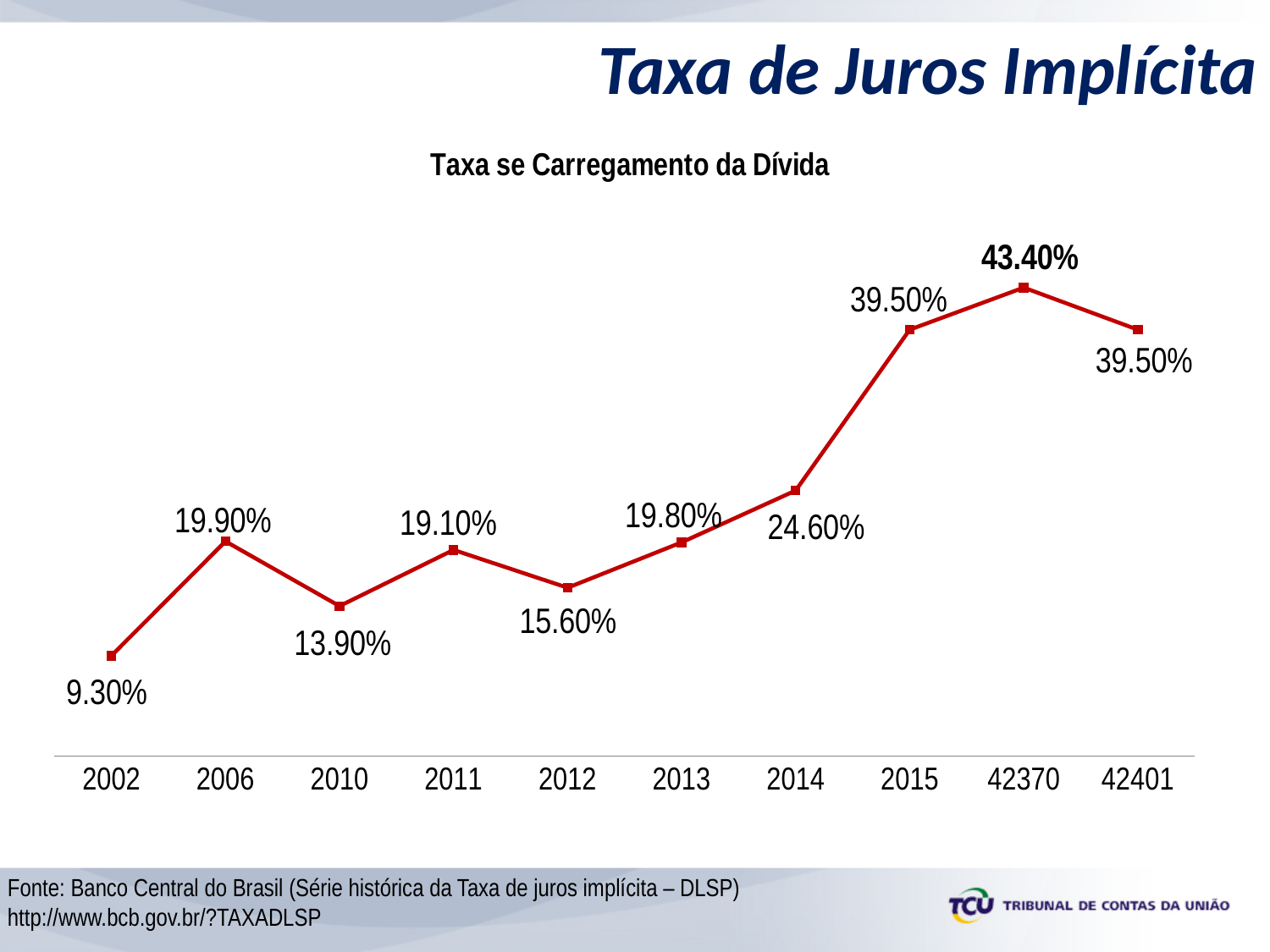
What type of chart is shown on the slide? line chart How many data points are plotted on the chart? 10 What is the value for 2012? 15.60% Which category has the lowest value? 2002 Which is larger, the value for 2006 or the value for 2010? 2006 What is the value for 2002? 9.30% Does the value rise or fall from 2013 to 2014? rise Which category has the highest value? 42370 What is the title of the chart? Taxa se Carregamento da Dívida What is the difference between the values for 2015 and 2014? 14.90% What is the value for 2015? 39.50% What is the value for 2014? 24.60%